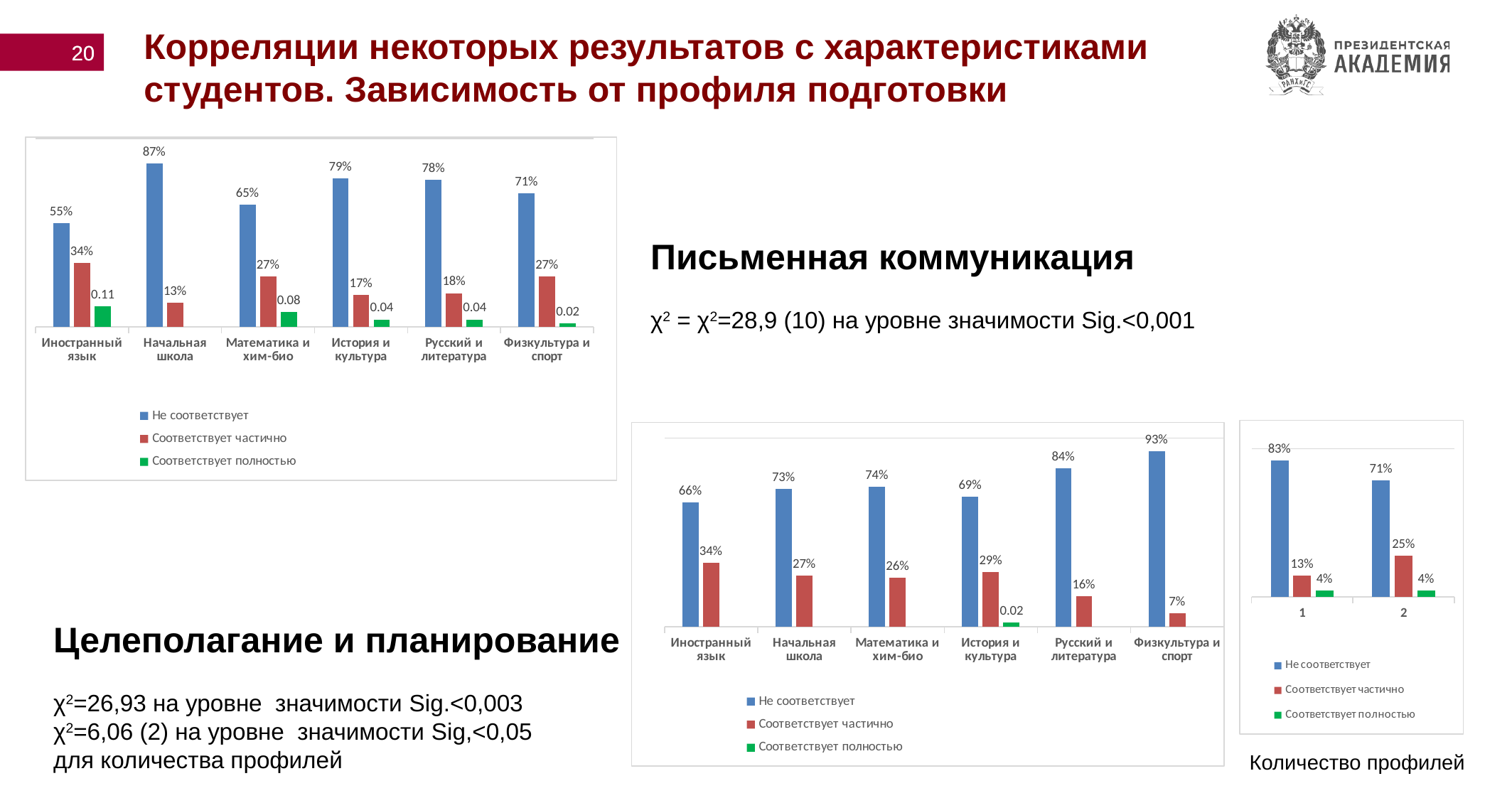
In the top-left chart, what is the value of 'Не соответствует' for 'Начальная школа'? 87% In the bottom-center chart, how many categories are shown on the x axis? 6 In the bottom-right chart, what is the 'Соответствует частично' value for category '2'? 25% In the top-left chart, which category has the highest 'Не соответствует' value? Начальная школа In the bottom-right chart, what is the difference between the 'Не соответствует' values for categories '1' and '2'? 12% In the top-left chart, what is the difference between the 'Не соответствует' values for 'История и культура' and 'Русский и литература'? 1% In the top-left chart, what is the 'Соответствует полностью' value for 'Иностранный язык'? 0.11 How many series does the legend of the bottom-right chart list? 3 In the bottom-center chart, which category has the lowest 'Не соответствует' value? Иностранный язык In the bottom-center chart, what is the 'Не соответствует' value for 'Физкультура и спорт'? 93% In the top-left chart, which category has the lowest 'Не соответствует' value? Иностранный язык In the bottom-center chart, which is larger: the 'Соответствует частично' value for 'Иностранный язык' or for 'Русский и литература'? Иностранный язык